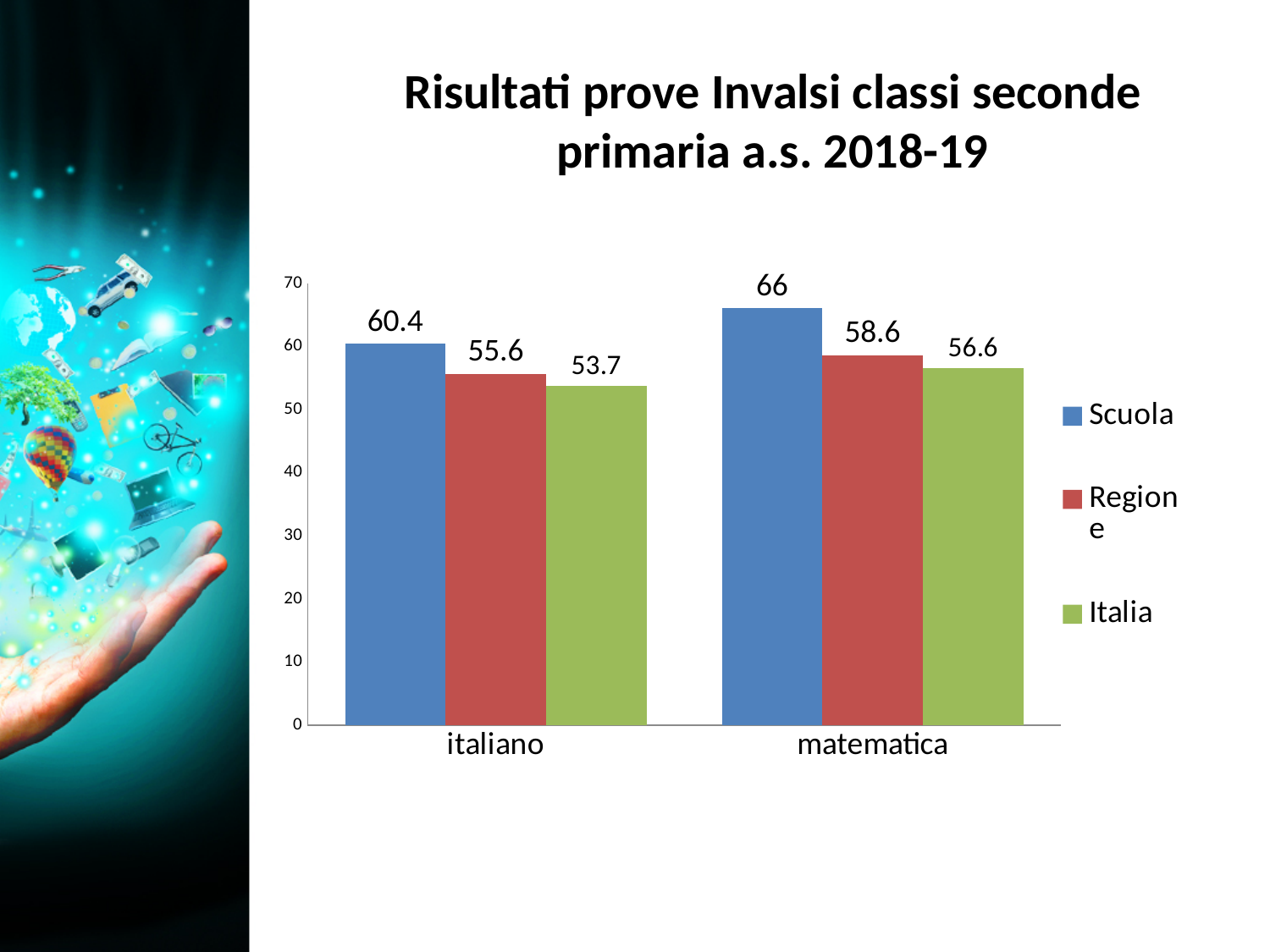
What is the value for Regione in matematica? 58.6 What is the value for Italia in italiano? 53.7 Which series has the highest value in matematica? Scuola What is the value for Scuola in italiano? 60.4 Which is larger, the Regione value in italiano or the Regione value in matematica? matematica What is the value for Scuola in matematica? 66 How many categories are shown on the x axis? 2 How many series does the legend list? 3 What is the difference between the Scuola values for matematica and italiano? 5.6 What kind of chart is shown on the slide? bar chart Which series has the lowest value in italiano? Italia What is the difference between the Scuola and Italia values in italiano? 6.7